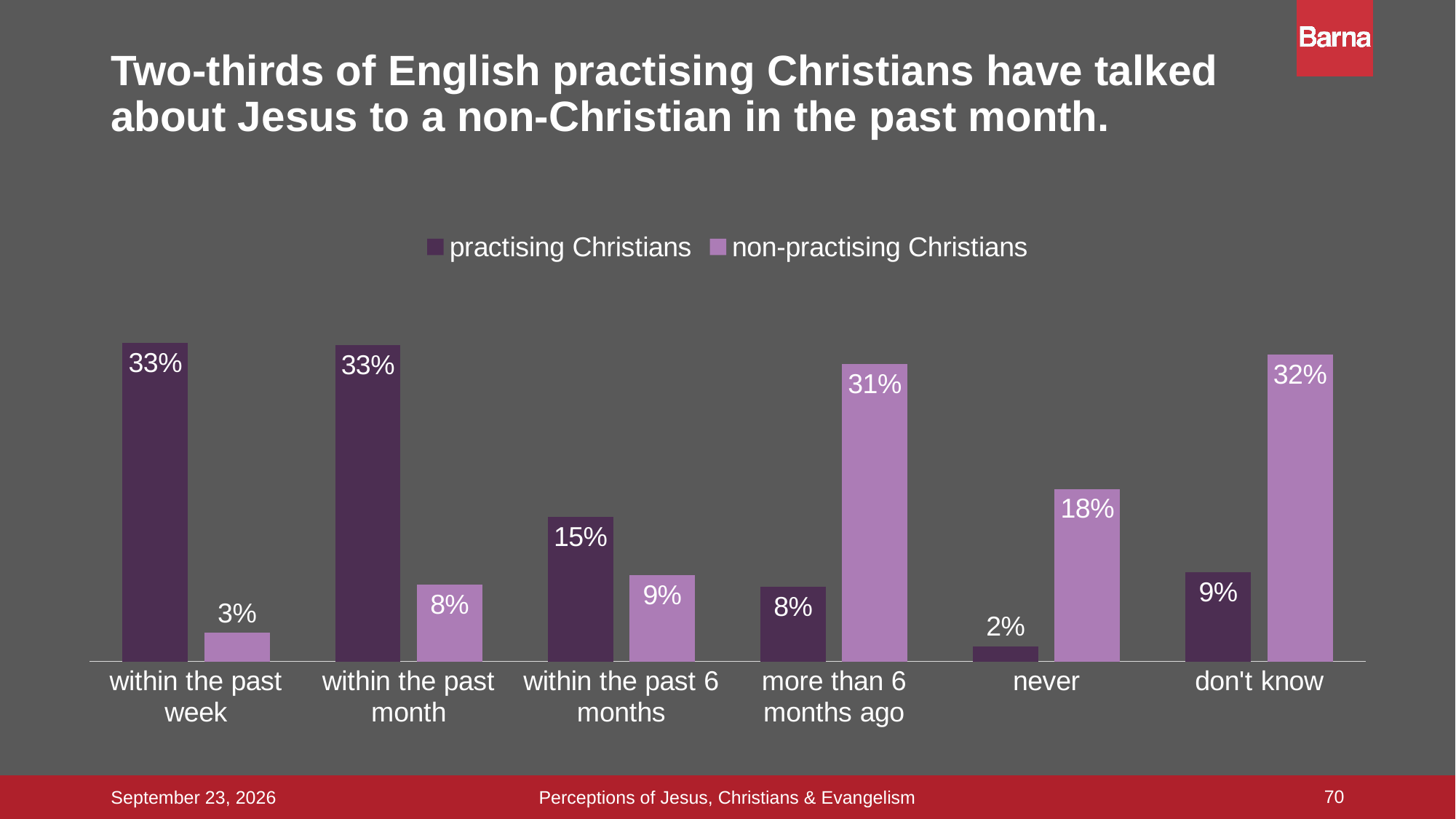
How many categories are shown on the x axis? 6 In the 'within the past 6 months' category, which series has the larger value? practising Christians What is the difference between the 'don't know' values for non-practising and practising Christians? 23 percentage points Which series is shown in the lighter purple colour? non-practising Christians What is the value for non-practising Christians in the 'never' category? 18% Which category has the highest value for non-practising Christians? don't know How many series does the legend list? 2 What is the difference between practising and non-practising Christians in the 'within the past week' category? 30 percentage points Which category has the lowest value for practising Christians? never What kind of chart is shown on the slide? bar chart What percentage of practising Christians talked about Jesus to a non-Christian within the past week? 33% What is the value for non-practising Christians in the 'more than 6 months ago' category? 31%